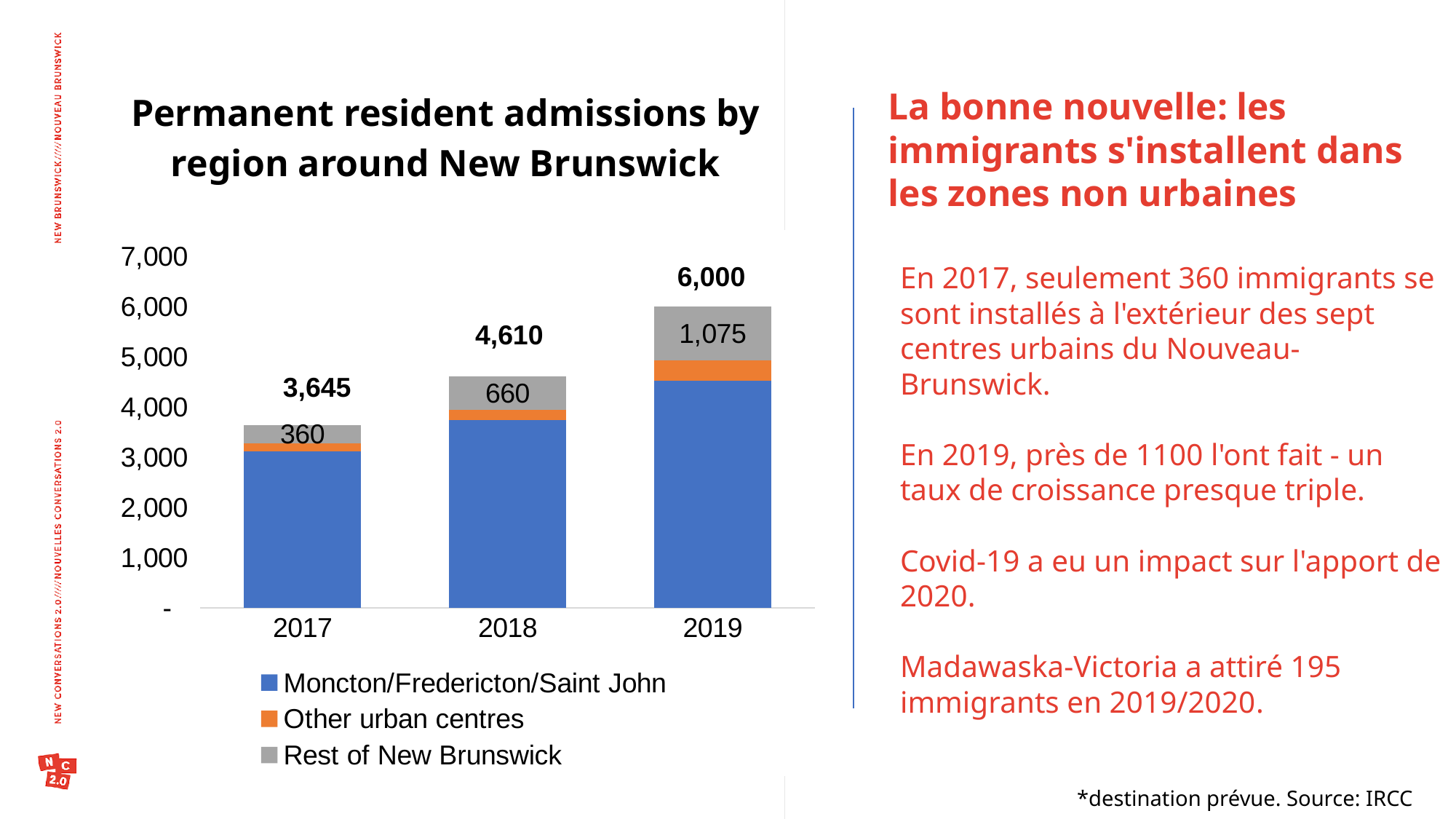
What is the difference between the total admissions in 2019 and 2017? 2,355 Which year has the lowest total admissions? 2017 Is the value for Moncton/Fredericton/Saint John in 2018 greater or less than 4,000? less Do the total admissions rise or fall from 2017 to 2019? Rise What is the total permanent resident admissions for 2017? 3,645 How many series does the legend list? 3 What is the difference between the Rest of New Brunswick values in 2019 and 2017? 715 What is the total permanent resident admissions for 2019? 6,000 What is the value for Rest of New Brunswick in 2018? 660 What kind of chart is shown on the slide? Stacked bar chart What is the value for Rest of New Brunswick in 2019? 1,075 Which year has the highest total admissions? 2019